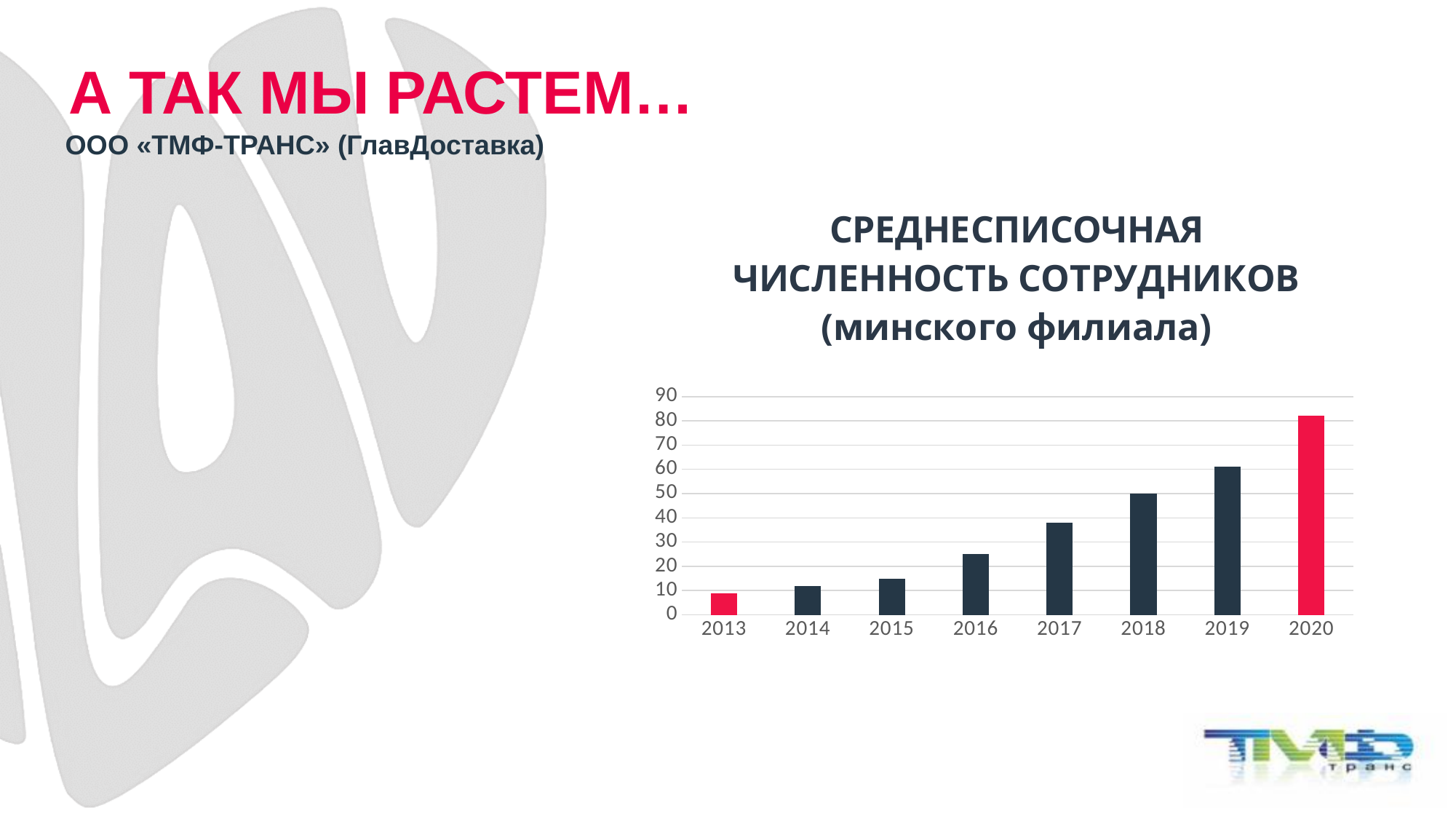
What is the title of the chart? СРЕДНЕСПИСОЧНАЯ ЧИСЛЕННОСТЬ СОТРУДНИКОВ (минского филиала) Which is larger, the value for 2016 or the value for 2018? 2018 Is the value for 2019 greater or less than 70? less Do the values rise or fall from 2013 to 2020? rise Is the value for 2017 greater or less than 30? greater Which year has the lowest value in the chart? 2013 How many years are shown on the x axis of the chart? 8 Which year has the highest value in the chart? 2020 Which two bars in the chart are coloured red? 2013 and 2020 What kind of chart is shown on the slide? bar chart